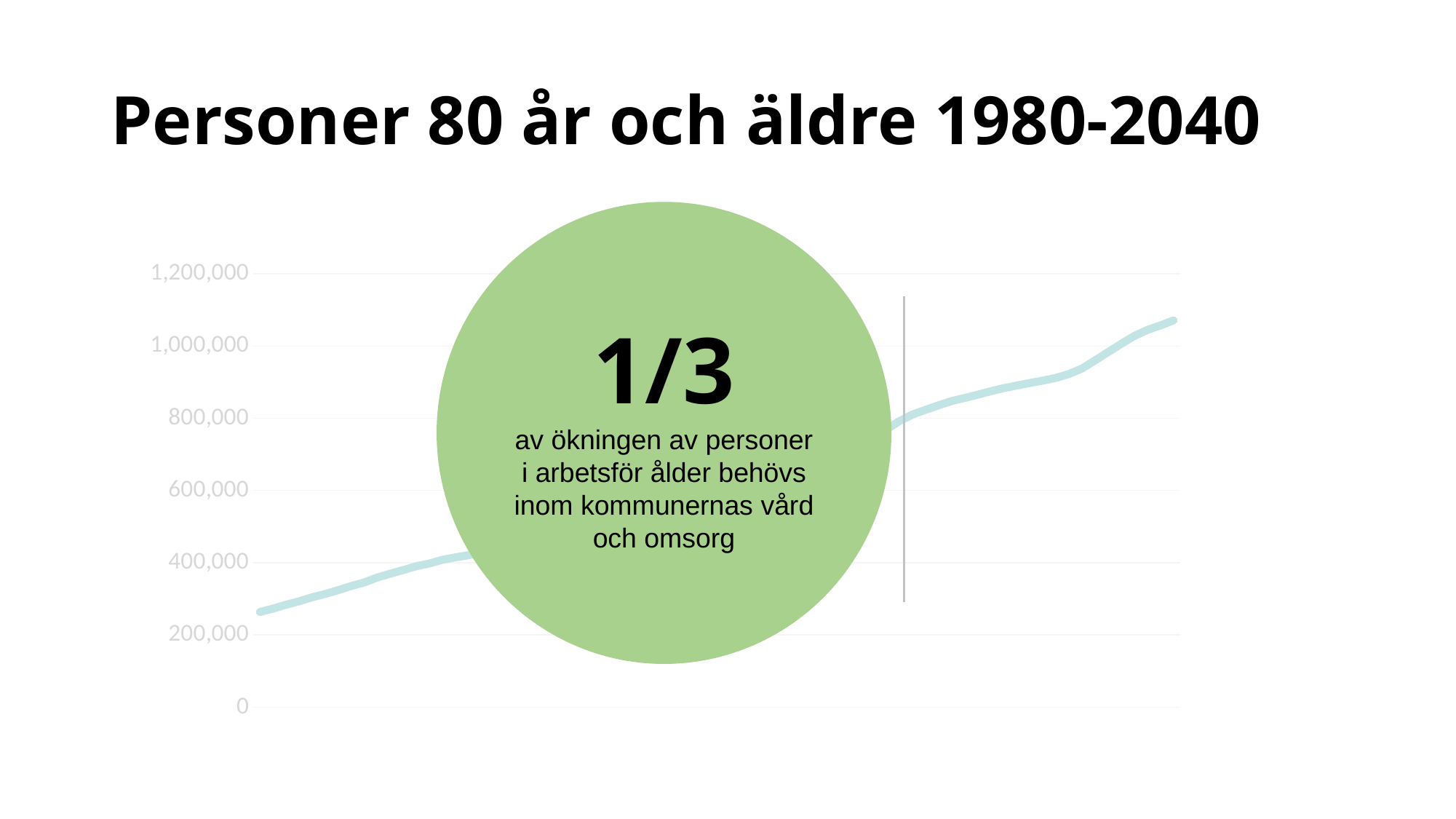
What is the title of the slide's chart? Personer 80 år och äldre 1980-2040 How many lines (series) are plotted on the chart? 1 Is the value at the right end of the line (the end of the period) greater or less than 1,000,000? greater What kind of chart is shown on the slide? line chart Is the value at the left end of the line (the start of the period) greater or less than 400,000? less Is the value at the right end of the line (the end of the period) greater or less than 1,200,000? less What is the highest value shown on the y axis? 1,200,000 Does the line rise or fall from left to right along the x axis? rises Which end of the line is higher, the left end or the right end? the right end